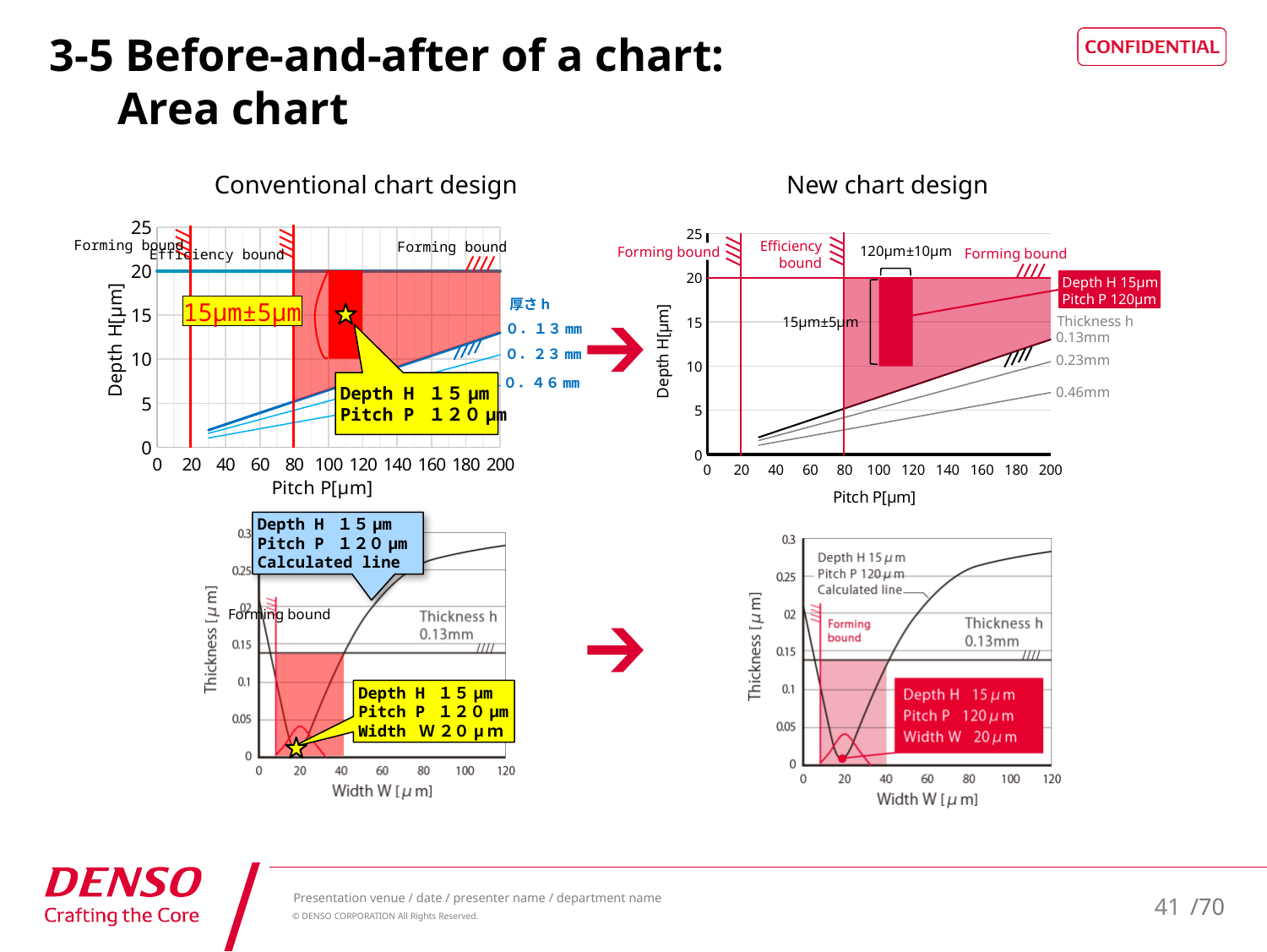
In the top-right 'New chart design' chart, which thickness h line is lowest at Pitch P 200? 0.46mm In the top-right 'New chart design' chart, do the thickness h lines rise or fall as Pitch P increases? rise In the top-right 'New chart design' chart, what Depth H is annotated for the highlighted point at Pitch P 120μm? 15μm What kind of chart is shown in the top-left 'Conventional chart design' panel? area chart In the bottom-right 'New chart design' chart, what Width W is annotated for the highlighted point? 20μm In the bottom-right 'New chart design' chart, is the calculated line at Width W 120 greater or less than 0.25? greater In the top-right 'New chart design' chart, what is the label of the y axis? Depth H[μm] In the top-right 'New chart design' chart, what is the label of the x axis? Pitch P[μm] In the top-right 'New chart design' chart, what pitch range is annotated above the highlighted red band? 120μm±10μm In the top-right 'New chart design' chart, how many thickness h lines are labelled? 3 In the top-right 'New chart design' chart, which thickness h line is highest at Pitch P 200? 0.13mm In the top-right 'New chart design' chart, is the value of the 0.13mm thickness line at Pitch P 200 greater or less than 10? greater